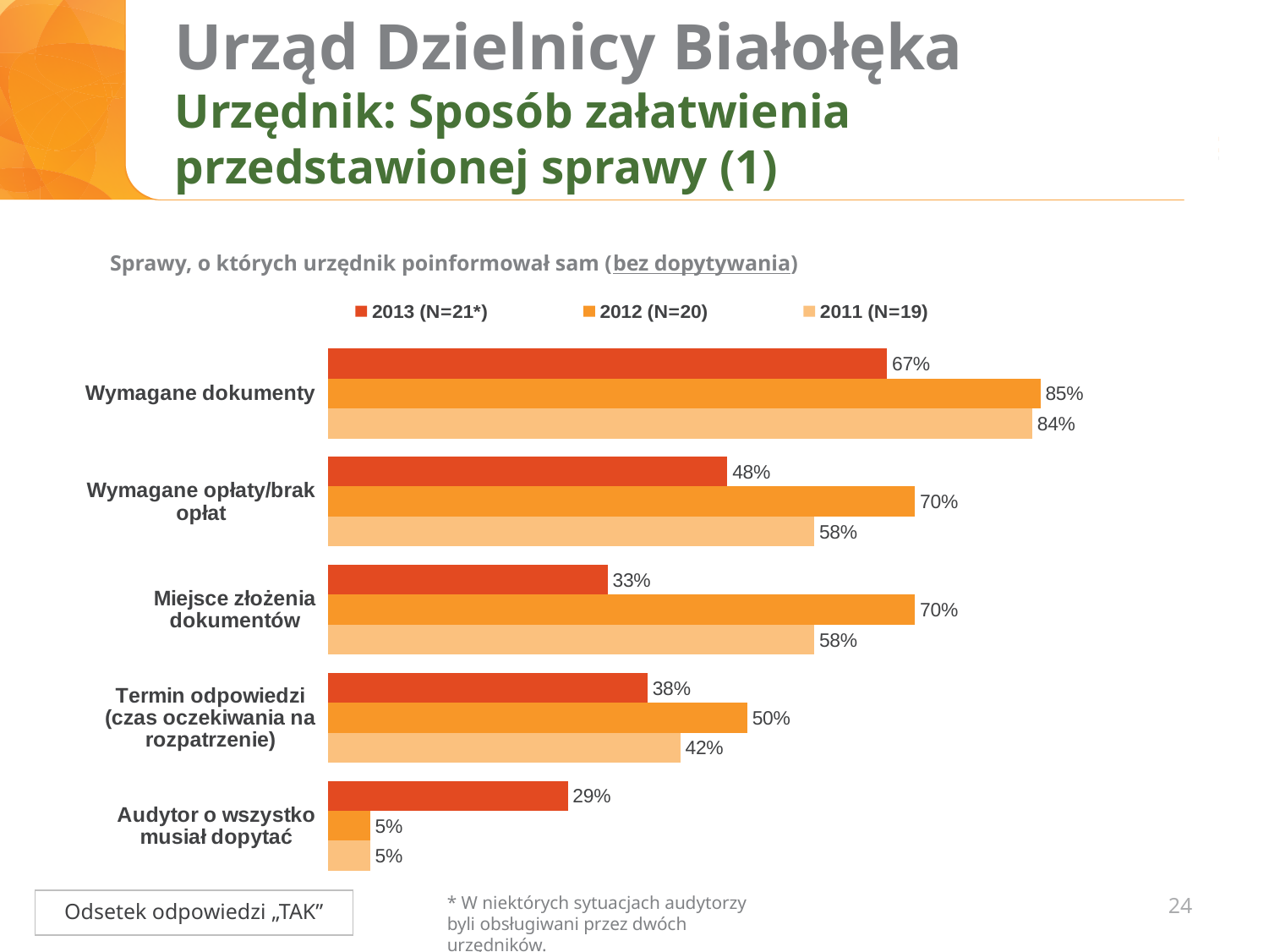
What is the value for "Miejsce złożenia dokumentów" in the 2012 (N=20) series? 70% Which category has the lowest value in the 2013 (N=21*) series? Audytor o wszystko musiał dopytać What is the value for "Termin odpowiedzi (czas oczekiwania na rozpatrzenie)" in the 2011 (N=19) series? 42% Which is larger for "Audytor o wszystko musiał dopytać": the 2013 (N=21*) value or the 2012 (N=20) value? 2013 (N=21*) What is the difference between the 2012 (N=20) and 2013 (N=21*) values for "Wymagane opłaty/brak opłat"? 22% What is the value for "Wymagane dokumenty" in the 2013 (N=21*) series? 67% What is the subtitle printed above the chart? Sprawy, o których urzędnik poinformował sam (bez dopytywania) What kind of chart is shown on the slide? Bar chart Which category has the highest value in the 2012 (N=20) series? Wymagane dokumenty How many categories are shown on the chart? 5 What is the difference between the 2012 (N=20) and 2011 (N=19) values for "Wymagane dokumenty"? 1% How many series does the legend list? 3